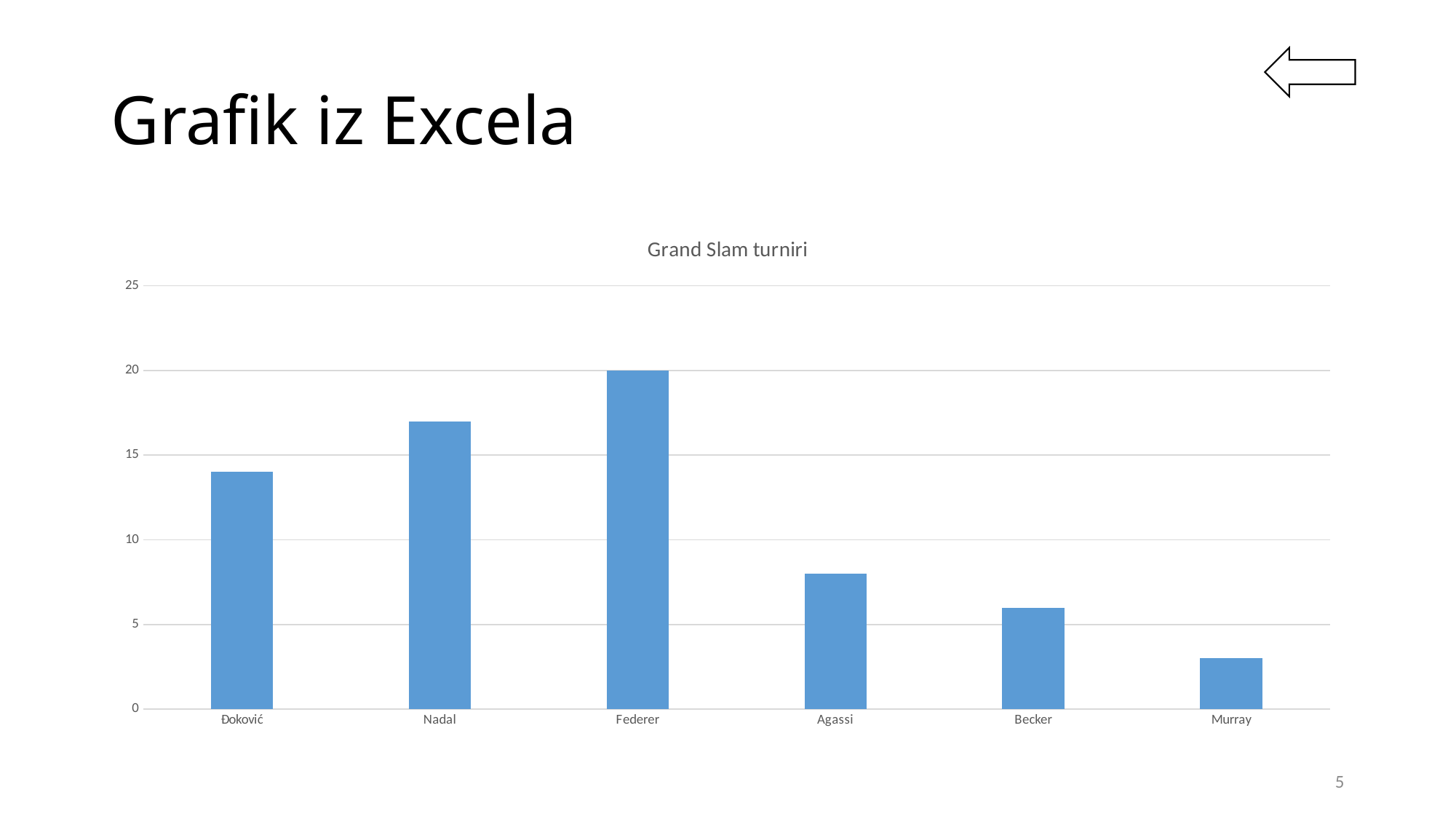
What is the title of the chart? Grand Slam turniri Which is larger, the value for Nadal or the value for Đoković? Nadal Is the value for Nadal greater or less than 15? greater Which is larger, the value for Agassi or the value for Becker? Agassi What is the value for Federer? 20 How many players (categories) are shown on the x axis? 6 Which player has the lowest bar? Murray Which player has the highest bar? Federer Is the value for Agassi greater or less than 10? less Is the value for Murray greater or less than 5? less What kind of chart is shown on the slide? bar chart